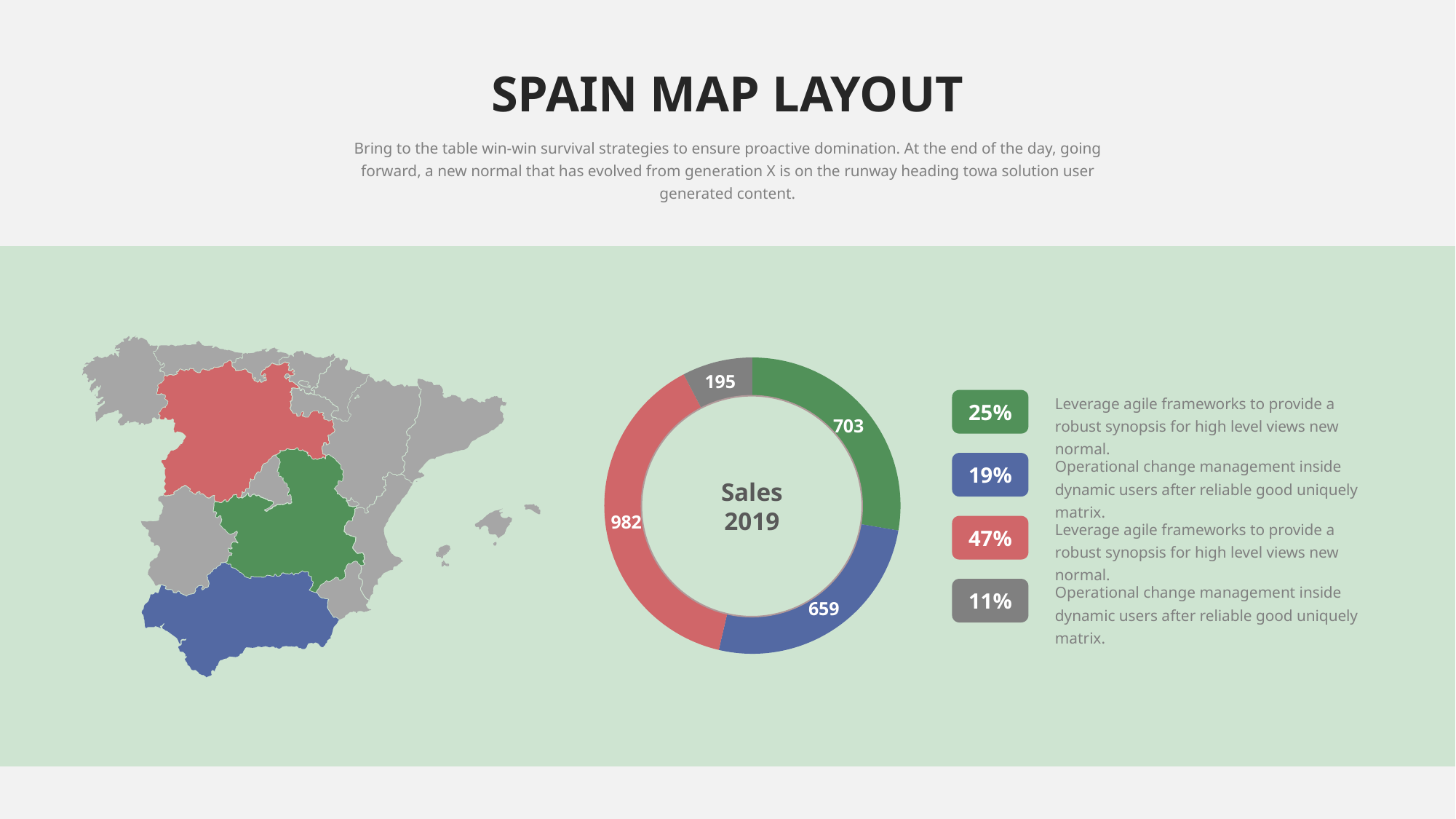
What is the difference between the red slice value and the green slice value? 279 How many slices does the doughnut chart have? 4 Which is larger, the green slice value or the blue slice value? Green (703) What is the value of the blue slice of the doughnut chart? 659 What kind of chart is shown on the slide? Doughnut chart What text appears in the centre of the doughnut chart? Sales 2019 What is the value of the grey slice of the doughnut chart? 195 Which slice of the doughnut chart has the largest value? Red (982) Which slice of the doughnut chart has the smallest value? Grey (195) What is the value of the red slice of the doughnut chart? 982 What is the value of the green slice of the doughnut chart? 703 What is the total of all four slice values in the doughnut chart? 2539